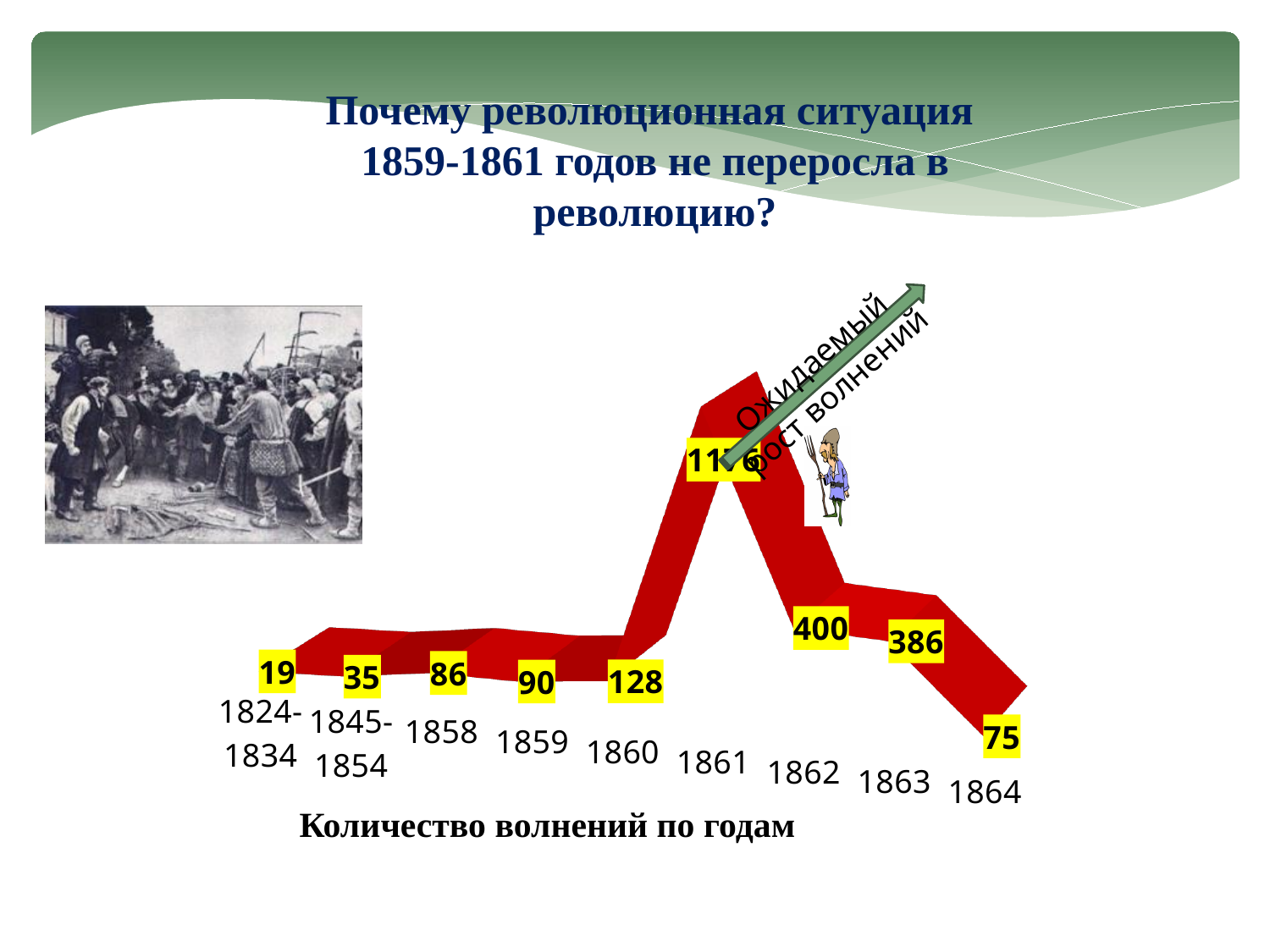
What is the value for 1860 in the chart 'Количество волнений по годам'? 128 What is the title of the chart? Количество волнений по годам Which category has the lowest value in the chart? 1824-1834 What is the value for the period 1824-1834? 19 What is the value for 1862 in the chart? 400 Which year has the highest value in the chart? 1861 What is the value for 1864 in the chart? 75 How many categories (years or periods) are shown on the x axis? 9 Do the values rise or fall from 1862 to 1864? fall What is the value for 1858? 86 Which is larger, the value for 1859 or the value for 1860? 1860 What is the difference between the values for 1862 and 1863? 14